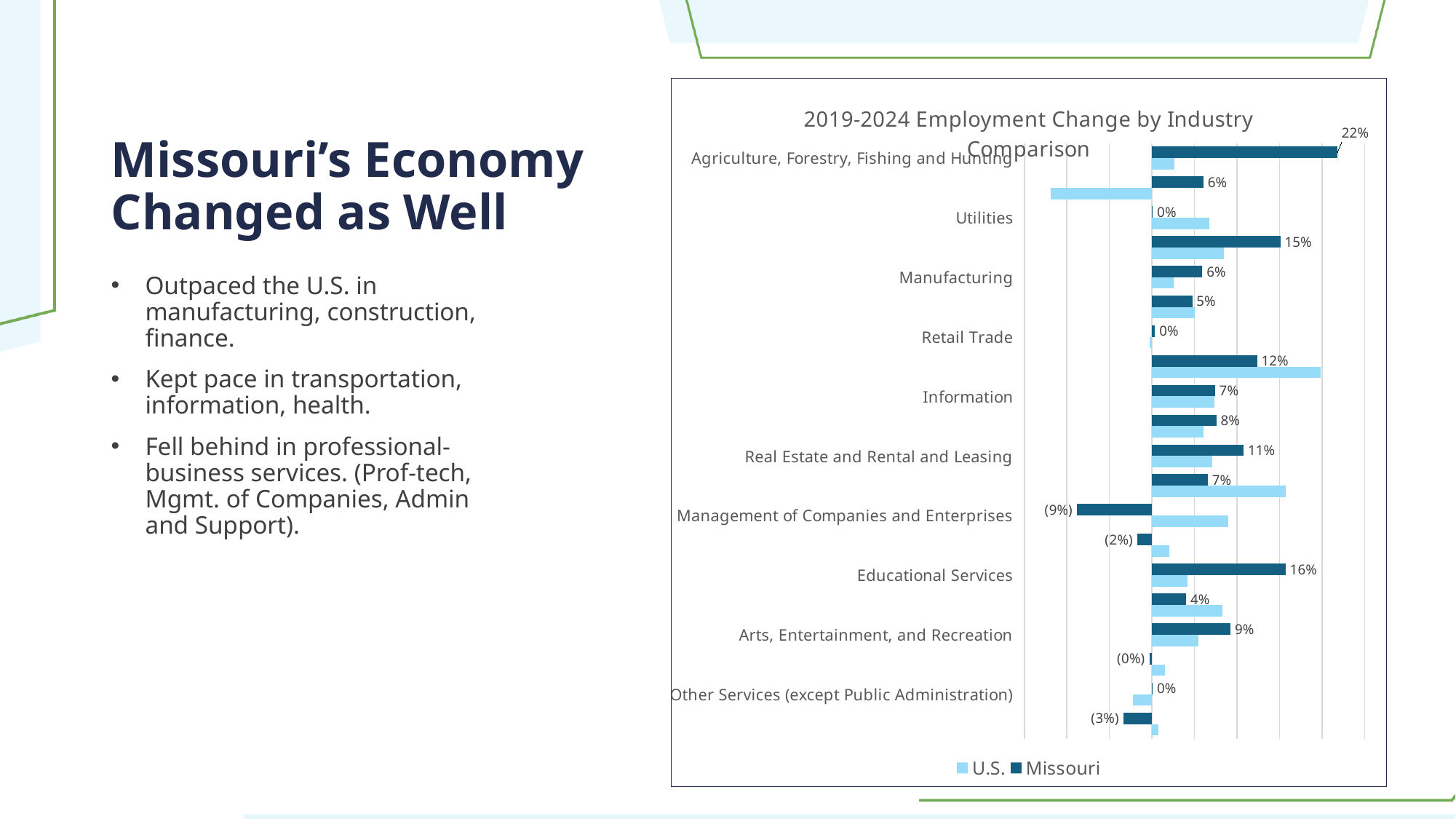
Which labeled industry has the lowest Missouri employment change? Management of Companies and Enterprises What is the Missouri employment change for Real Estate and Rental and Leasing? 11% What type of chart is shown on the slide? Bar chart What is the Missouri employment change for Management of Companies and Enterprises? (9%) What is the Missouri employment change for Agriculture, Forestry, Fishing and Hunting? 22% Which labeled industry has the highest Missouri employment change? Agriculture, Forestry, Fishing and Hunting What is the difference between the Missouri employment change for Educational Services and for Real Estate and Rental and Leasing? 5% How many series does the chart legend list? 2 What is the Missouri employment change for Arts, Entertainment, and Recreation? 9% For Manufacturing, which series shows the larger employment change, U.S. or Missouri? Missouri What is the Missouri employment change for Educational Services? 16% What is the title of the chart? 2019-2024 Employment Change by Industry Comparison